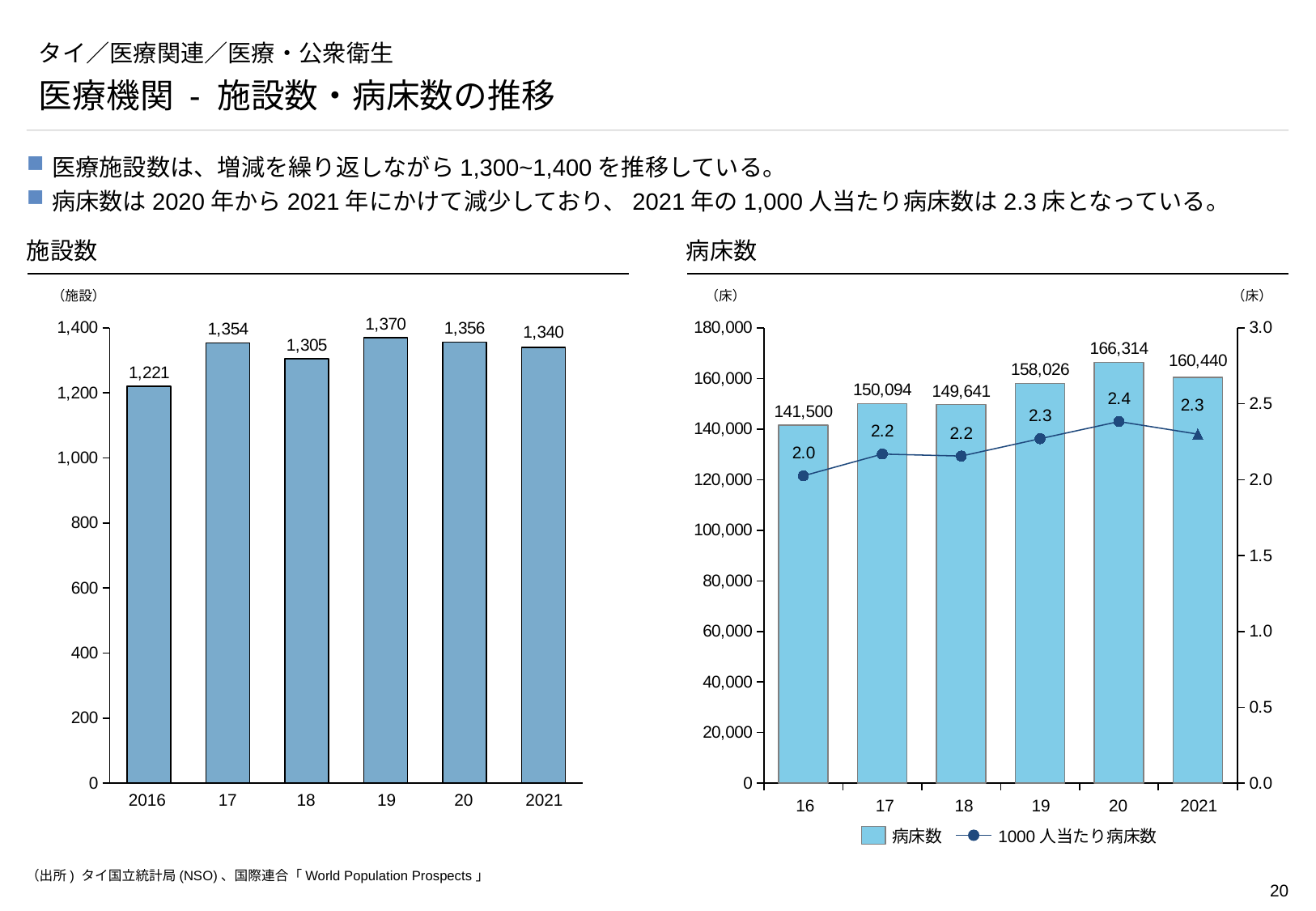
In the 施設数 chart on the left, what is the difference between the values for 19 and 18? 65 What kind of chart is the 施設数 chart on the left? Bar chart In the 病床数 chart on the right, which year has the lowest 病床数? 16 In the 病床数 chart on the right, how many series does the legend list? 2 In the 施設数 chart on the left, how many years are plotted? 6 In the 病床数 chart on the right, is the 病床数 for 19 larger than for 18? Yes In the 施設数 chart on the left, which year has the highest number of facilities? 19 In the 病床数 chart on the right, what is the 1000 人当たり病床数 value for 2021? 2.3 In the 施設数 chart on the left, what is the value for 2016? 1,221 In the 病床数 chart on the right, what is the difference in 病床数 between 20 and 2021? 5,874 In the 病床数 chart on the right, what is the 病床数 value for 20? 166,314 In the 施設数 chart on the left, which year has the lowest number of facilities? 2016